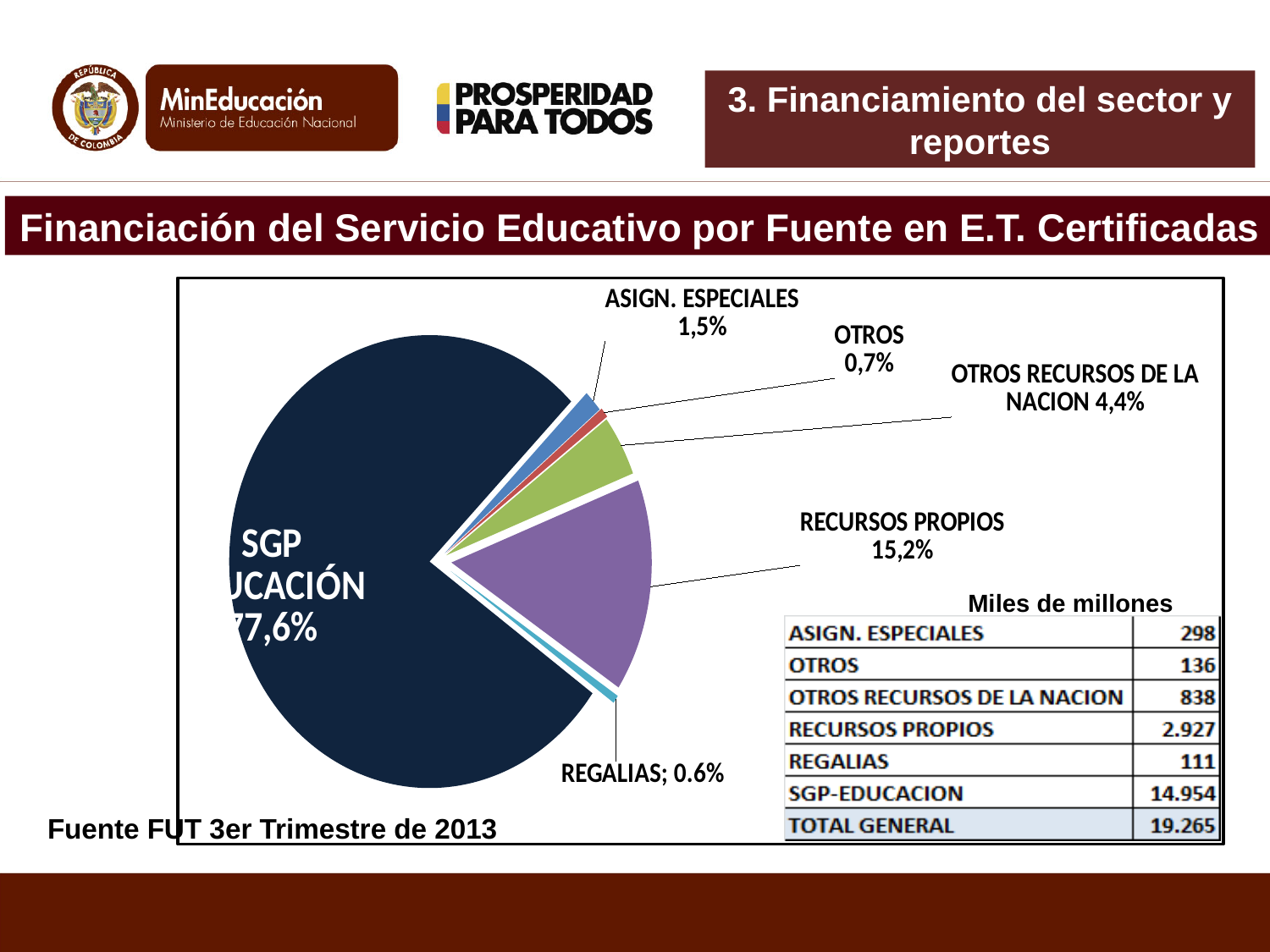
According to the table, what is the value in miles de millones for RECURSOS PROPIOS? 2.927 Which is larger, the share for RECURSOS PROPIOS or the share for OTROS RECURSOS DE LA NACION? RECURSOS PROPIOS Which category has the smallest slice of the pie? REGALIAS According to the table, what is the TOTAL GENERAL in miles de millones? 19.265 What share of the pie does RECURSOS PROPIOS represent? 15,2% What kind of chart is shown on the slide? Pie chart What share of the pie does REGALIAS represent? 0.6% What share of the pie does OTROS RECURSOS DE LA NACION represent? 4,4% How many slices does the pie chart have? 6 Which category has the largest slice of the pie? SGP EDUCACIÓN